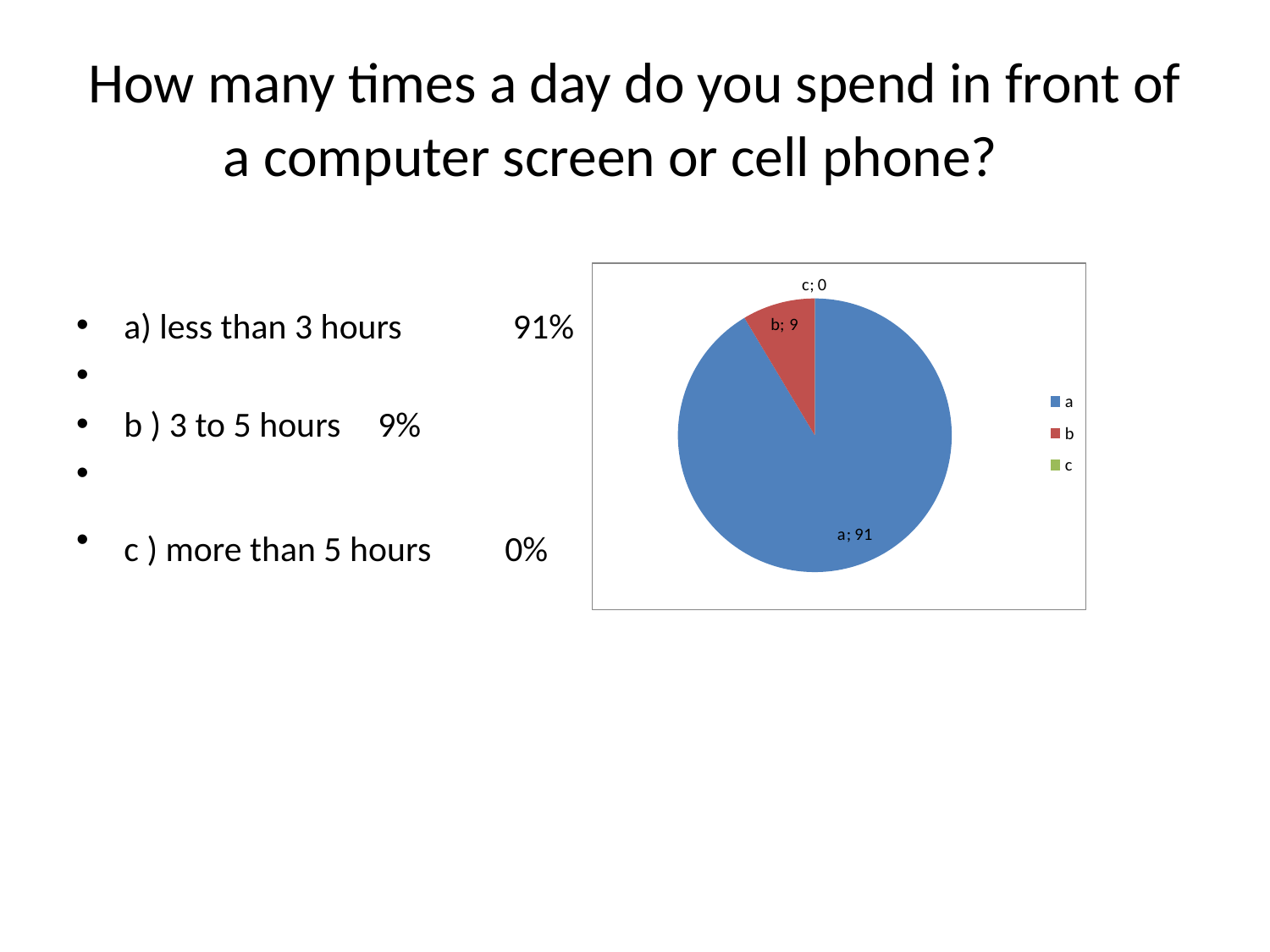
What is the value shown for slice a in the pie chart? 91 What kind of chart is shown on the slide? pie chart What is the value shown for slice c in the pie chart? 0 What is the difference between the values for slices a and b? 82 What colour is slice b in the pie chart? red Which slice of the pie chart is the largest? a How many entries does the legend of the pie chart list? 3 What colour is slice a in the pie chart? blue How many categories are shown in the pie chart? 3 What is the value shown for slice b in the pie chart? 9 Which is larger, the value for slice a or slice b? a Which slice of the pie chart is the smallest? c